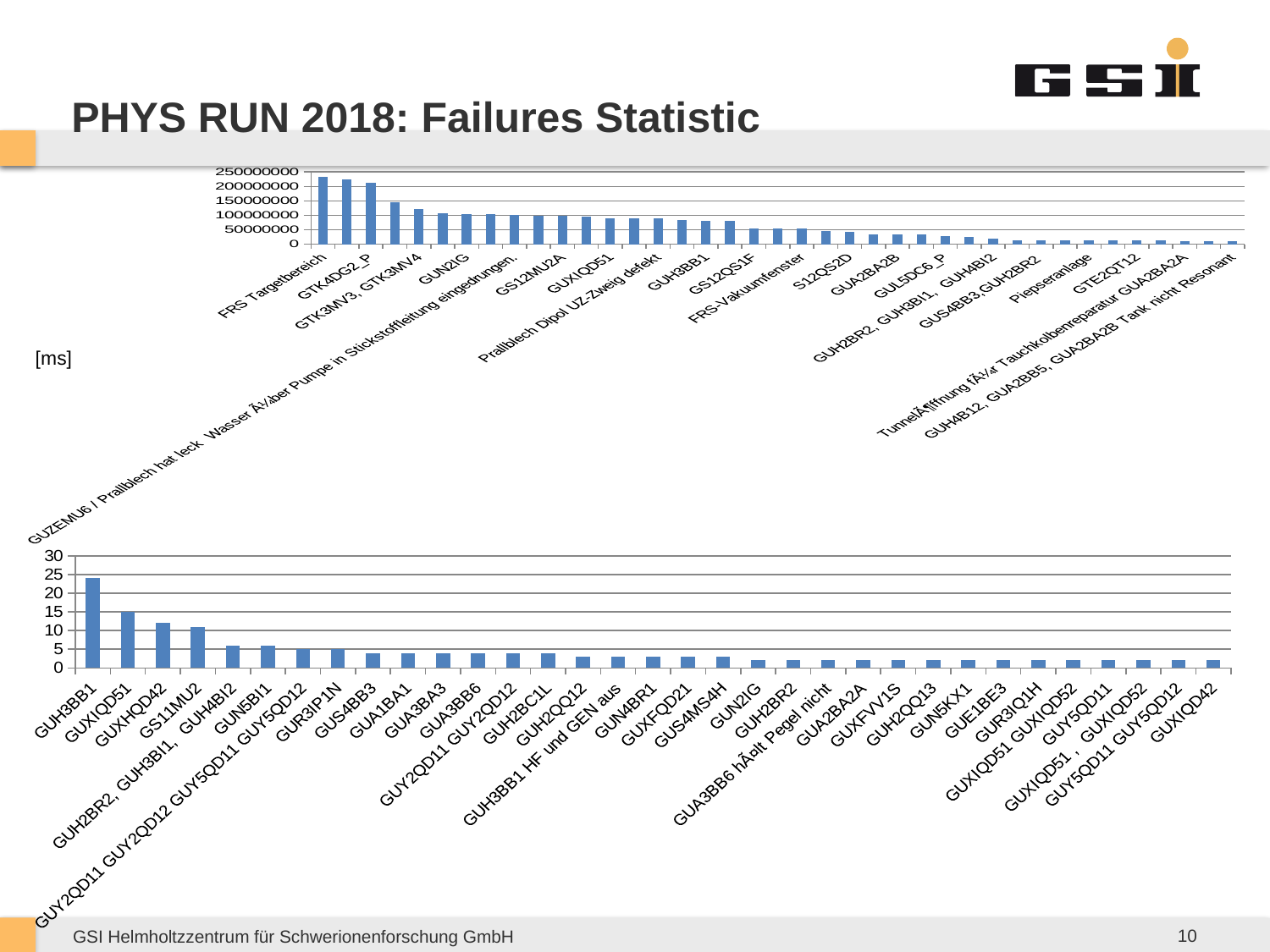
In the bottom chart, which category has the highest value? GUH3BB1 In the top chart, which is larger, the value for FRS Targetbereich or the value for GUN2IG? FRS Targetbereich In the bottom chart, is the value for GUH3BB1 greater or less than 20? greater In the bottom chart, which is larger, the value for GUH3BB1 or the value for GUXIQD51? GUH3BB1 In the bottom chart, is the value for GUXIQD42 greater or less than 5? less What kind of chart is the bottom chart? bar chart In the top chart, is the value for FRS Targetbereich greater or less than 200000000? greater In the top chart, do the values rise or fall from left to right along the x axis? fall In the top chart, which category has the highest value? FRS Targetbereich